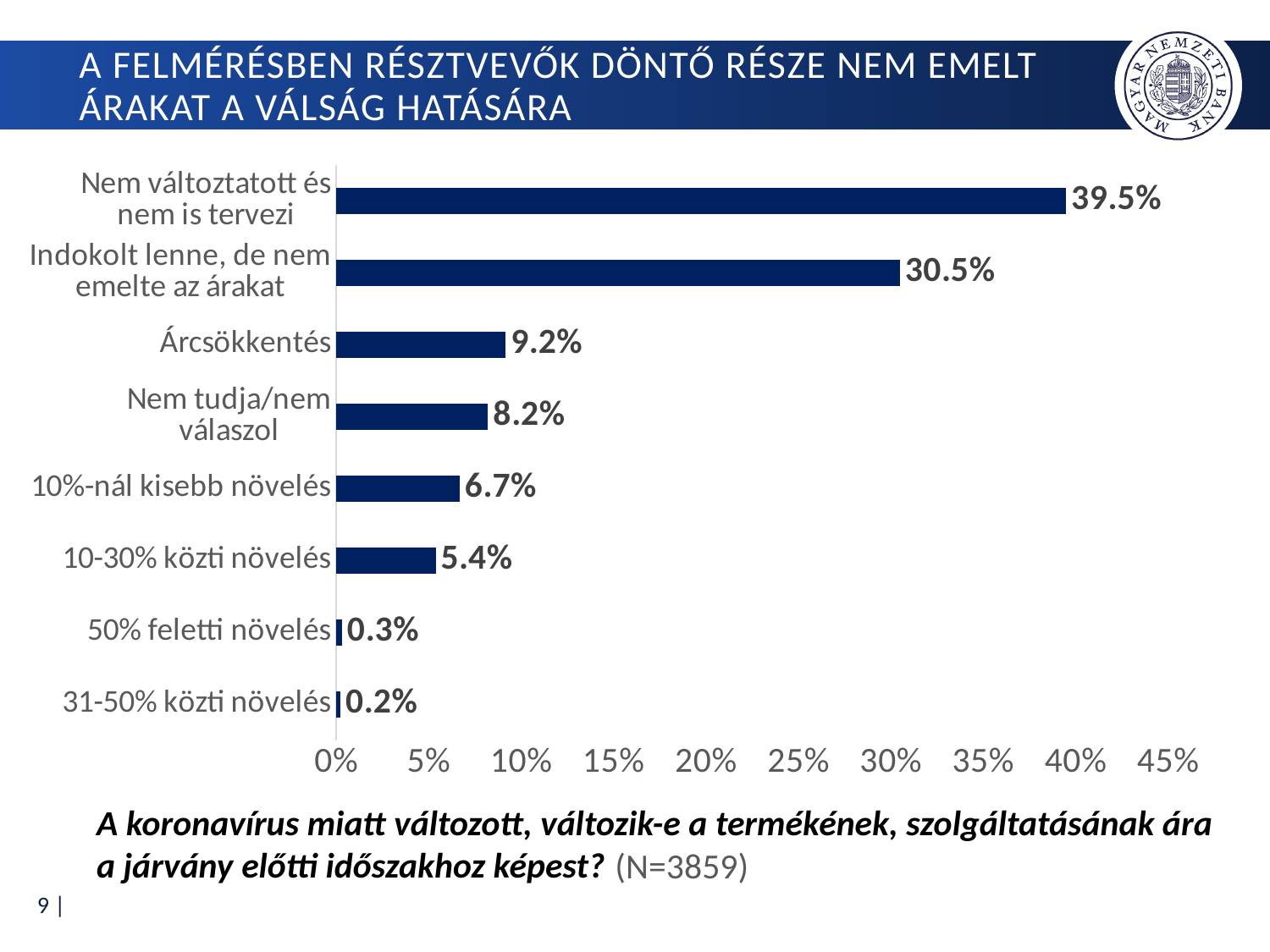
What is the value for "50% feletti növelés"? 0.3% What is the value for "10-30% közti növelés"? 5.4% What kind of chart is shown on the slide? Bar chart What is the value for "Árcsökkentés"? 9.2% How many categories are shown in the chart? 8 What is the value for "Nem változtatott és nem is tervezi"? 39.5% Which category has the lowest value? 31-50% közti növelés What is the difference between "Nem változtatott és nem is tervezi" and "Indokolt lenne, de nem emelte az árakat"? 9 percentage points Which category has the highest value? Nem változtatott és nem is tervezi What is the highest tick value shown on the horizontal axis? 45% Which is larger: "Nem tudja/nem válaszol" or "10%-nál kisebb növelés"? Nem tudja/nem válaszol Is the value for "Indokolt lenne, de nem emelte az árakat" greater or less than 25%? greater